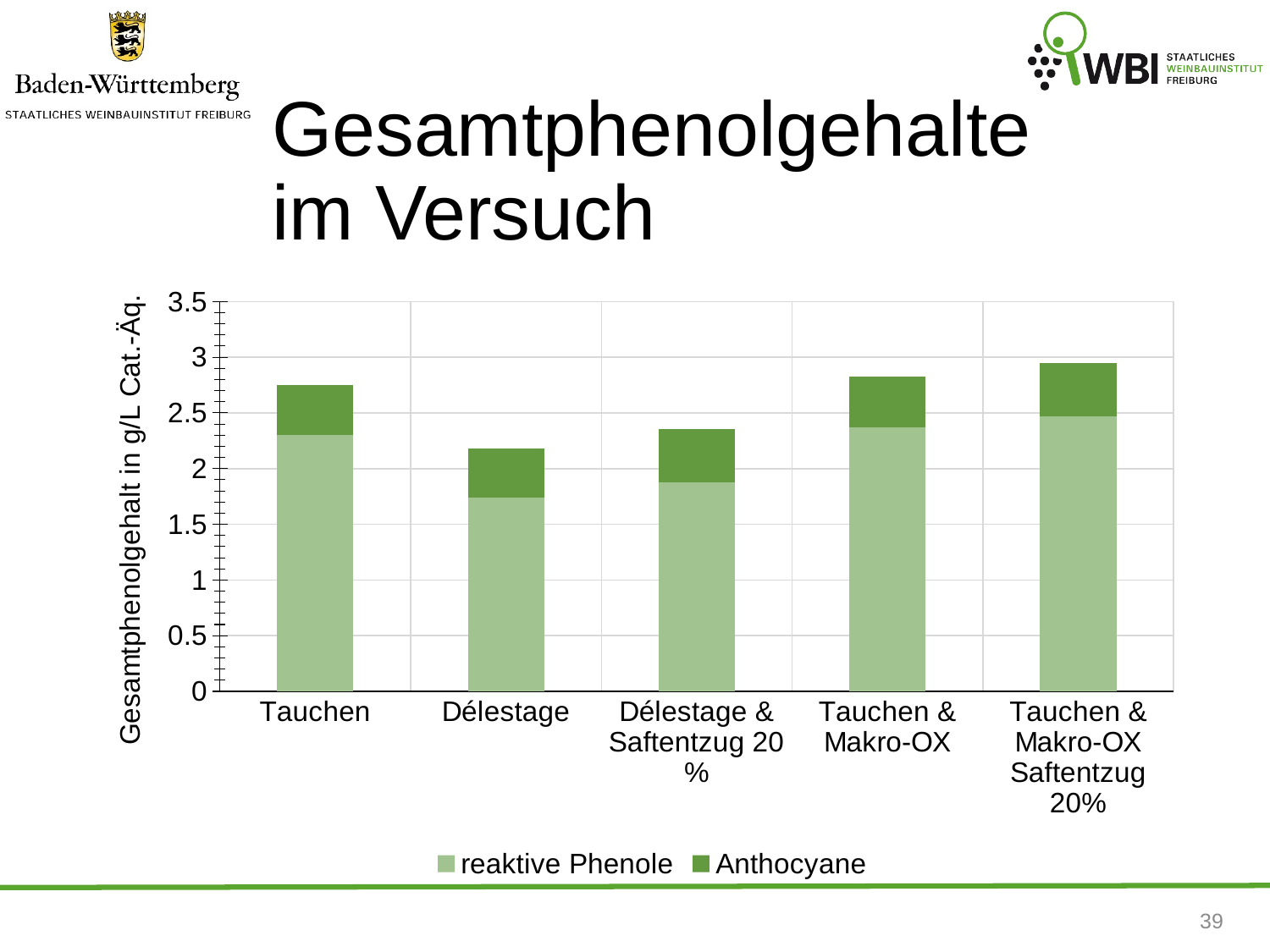
What kind of chart is shown on the slide? stacked bar chart Which has the larger total bar, Tauchen or Délestage? Tauchen Which category has the lowest value for reaktive Phenole? Délestage Is the reaktive Phenole value for Délestage greater or less than 2? less Which has the larger total bar, Délestage or Délestage & Saftentzug 20 %? Délestage & Saftentzug 20 % How many series does the legend list? 2 Which category has the highest total bar? Tauchen & Makro-OX Saftentzug 20% What is the label of the y axis? Gesamtphenolgehalt in g/L Cat.-Äq. How many categories are shown on the x axis of the chart? 5 Is the total value for Délestage greater or less than 2.5? less Is the total value for Tauchen greater or less than 2.5? greater Which category has the lowest total bar? Délestage